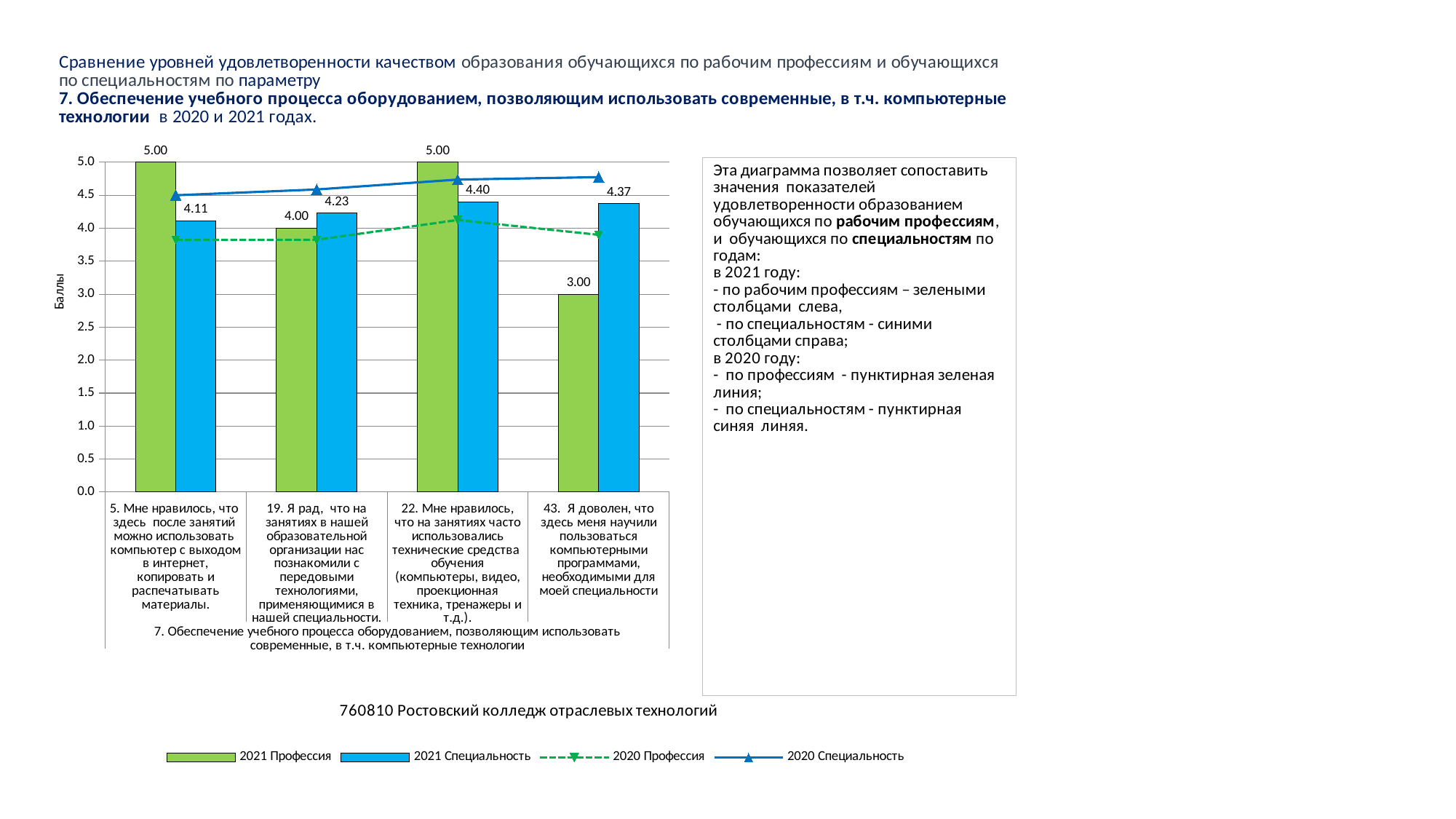
Is the 2020 Профессия value for statement 5 greater or less than 4.0? less How many statements (categories) are shown on the x axis of the chart? 4 Which statement has the highest 2021 Специальность value? 22. Мне нравилось, что на занятиях часто использовались технические средства обучения How many series does the chart legend list? 4 What is the value of the 2021 Специальность bar for statement 43 ("Я доволен, что здесь меня научили пользоваться компьютерными программами...")? 4.37 What is the value of the 2021 Специальность bar for statement 19 ("Я рад, что на занятиях в нашей образовательной организации нас познакомили с передовыми технологиями...")? 4.23 Which statement has the lowest 2021 Профессия value? 43. Я доволен, что здесь меня научили пользоваться компьютерными программами, необходимыми для моей специальности For statement 43, what is the difference between the 2021 Специальность value and the 2021 Профессия value? 1.37 Does the 2020 Специальность line rise or fall from the first statement to the last? rises Is the 2020 Специальность value for statement 43 greater or less than 4.5? greater What is the value of the 2021 Профессия bar for statement 5 ("Мне нравилось, что здесь после занятий можно использовать компьютер...")? 5.00 For statement 19, which is larger: the 2021 Профессия value or the 2021 Специальность value? 2021 Специальность